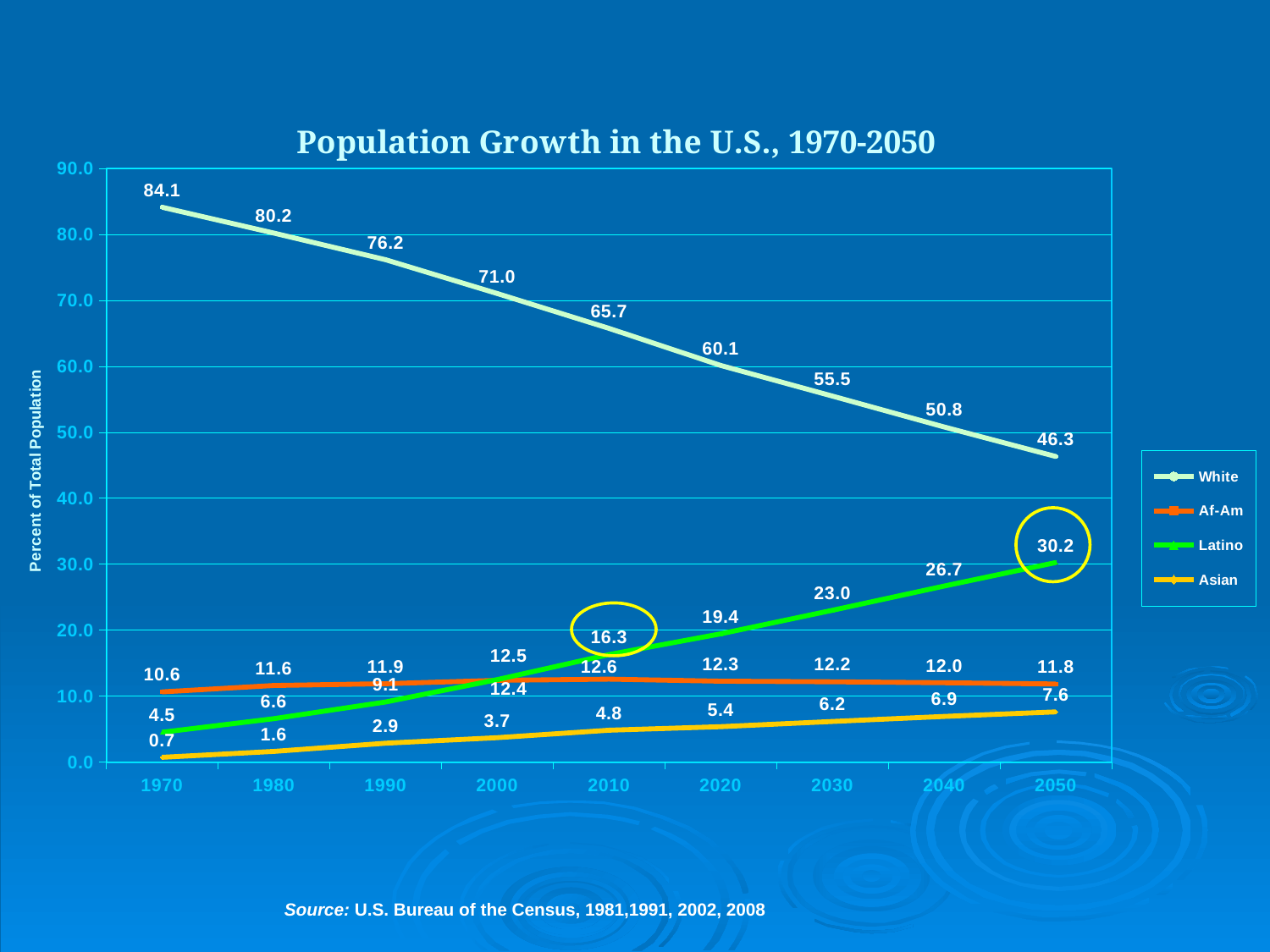
Which is larger in 2030, the Latino value or the Af-Am value? Latino In which year is the Asian series at its lowest? 1970 Does the White series rise or fall from 1970 to 2050? Fall In which year is the Af-Am series at its highest? 2010 How many series does the legend list? 4 What is the difference between the White value in 1970 and the White value in 2050? 37.8 What is the value for White in 1970? 84.1 What is the value for Af-Am in 2000? 12.4 What kind of chart is shown on the slide? Line chart What is the value for Latino in 2050? 30.2 How many years are plotted along the x axis? 9 What is the value for Asian in 2010? 4.8